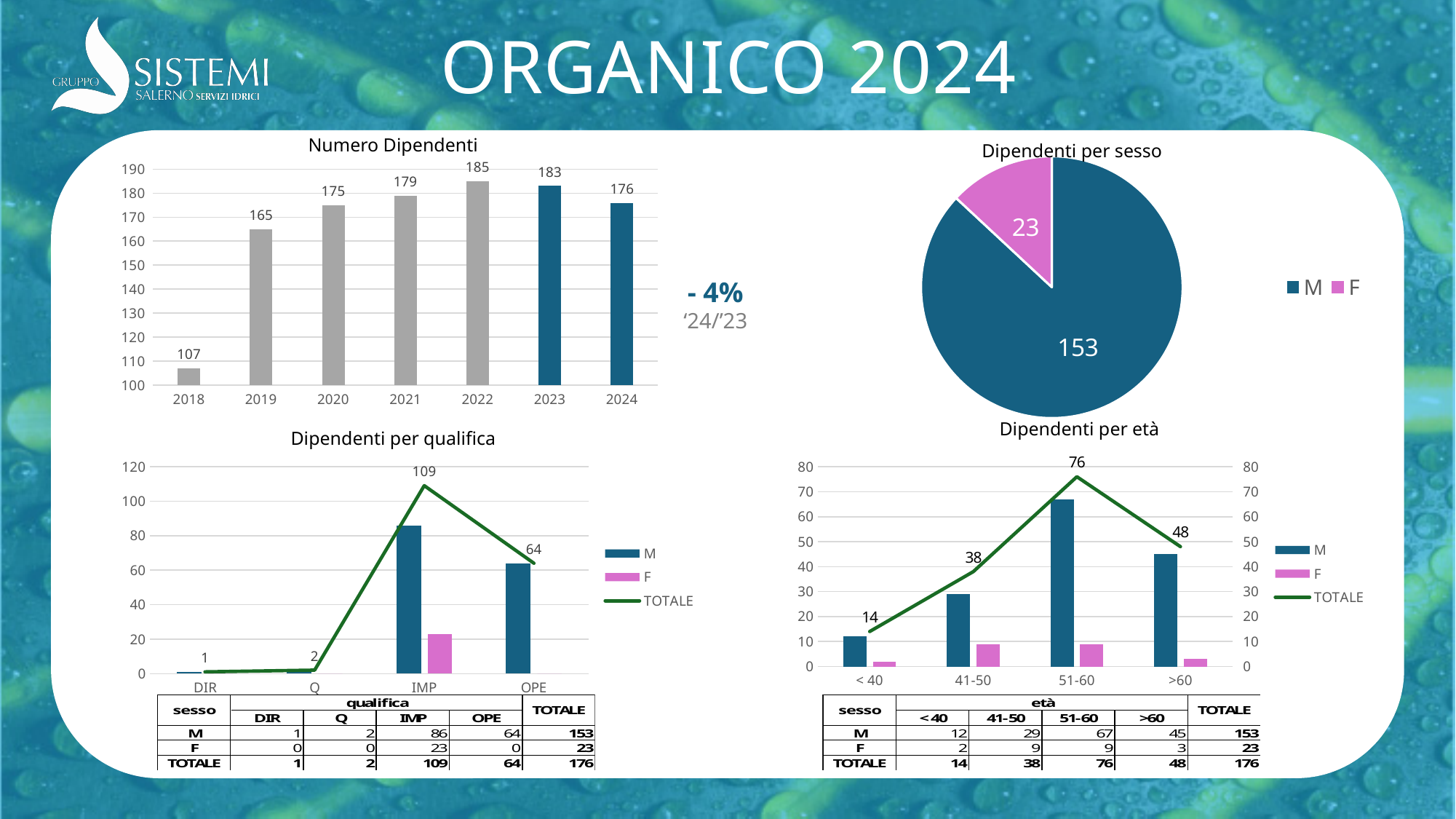
In the 'Numero Dipendenti' chart, what is the difference between the values for 2023 and 2024? 7 How many series does the legend of the 'Dipendenti per qualifica' chart list? 3 In the 'Dipendenti per qualifica' chart, what is the TOTALE value for IMP? 109 In the 'Numero Dipendenti' chart, which year has the highest number of employees? 2022 In the 'Dipendenti per sesso' pie chart, what is the value for F? 23 In the 'Numero Dipendenti' chart, which year has the lowest number of employees? 2018 In the 'Dipendenti per sesso' pie chart, which slice is larger, M or F? M In the 'Numero Dipendenti' chart, how many years are shown on the x axis? 7 In the 'Numero Dipendenti' chart, what is the value for 2022? 185 In the 'Dipendenti per età' chart, what is the TOTALE value for the 51-60 age group? 76 What kind of chart is 'Numero Dipendenti'? Bar chart In the 'Dipendenti per età' chart, which age group has the highest TOTALE? 51-60